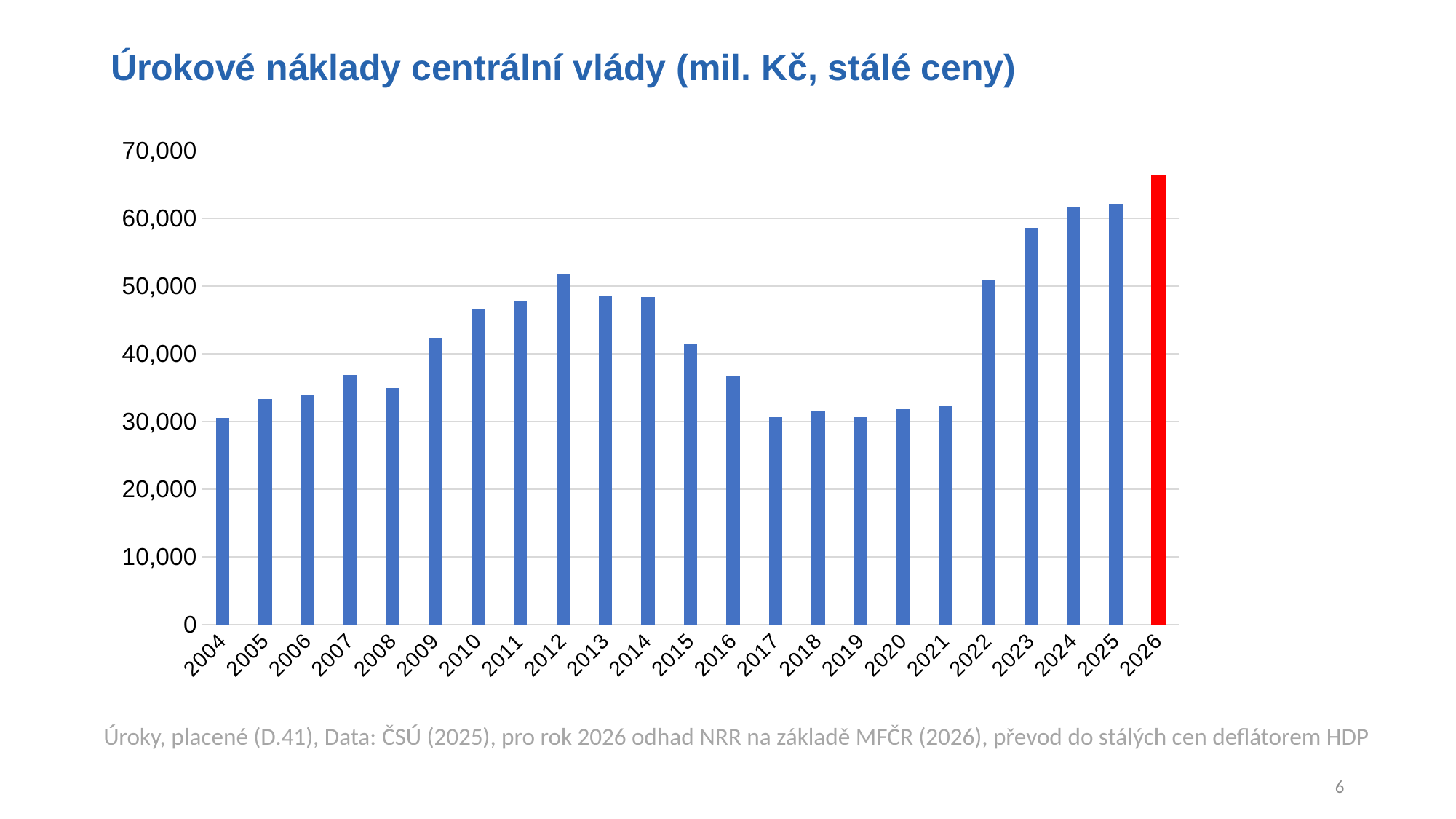
Is the value for 2026 greater or less than 60,000? greater Which year's bar is coloured red in the chart? 2026 Is the value for 2009 greater or less than 40,000? greater Which year has the highest interest cost in the chart? 2026 Which is larger, the value for 2023 or the value for 2012? 2023 How many years are shown on the x axis of the chart? 23 Is the value for 2016 greater or less than 40,000? less Do the values rise or fall from 2022 to 2026? rise Which is larger, the value for 2010 or the value for 2016? 2010 What kind of chart is shown on the slide? bar chart